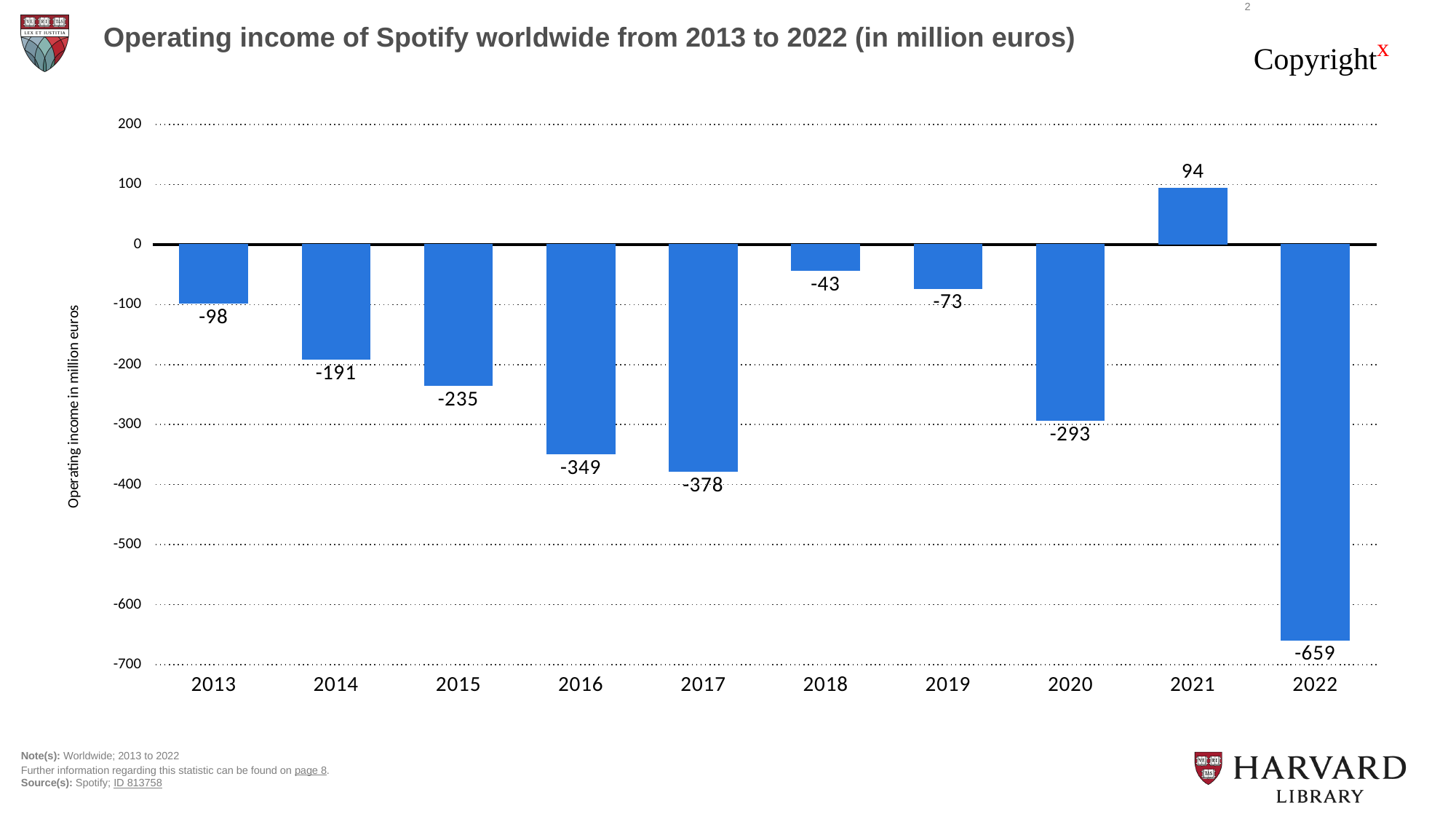
Did the operating income rise or fall from 2019 to 2020? Fall What was Spotify's operating income in 2018? -43 What is the label of the vertical axis? Operating income in million euros Which year had a higher operating income, 2016 or 2020? 2020 What is the difference between the operating income in 2021 and in 2022? 753 Which year has the lowest operating income? 2022 How many years are shown on the x axis? 10 Is the value for 2015 greater or less than -200? less What was Spotify's operating income in 2017? -378 Which year has the highest operating income? 2021 What was Spotify's operating income in 2021? 94 What kind of chart is shown on the slide? Bar chart